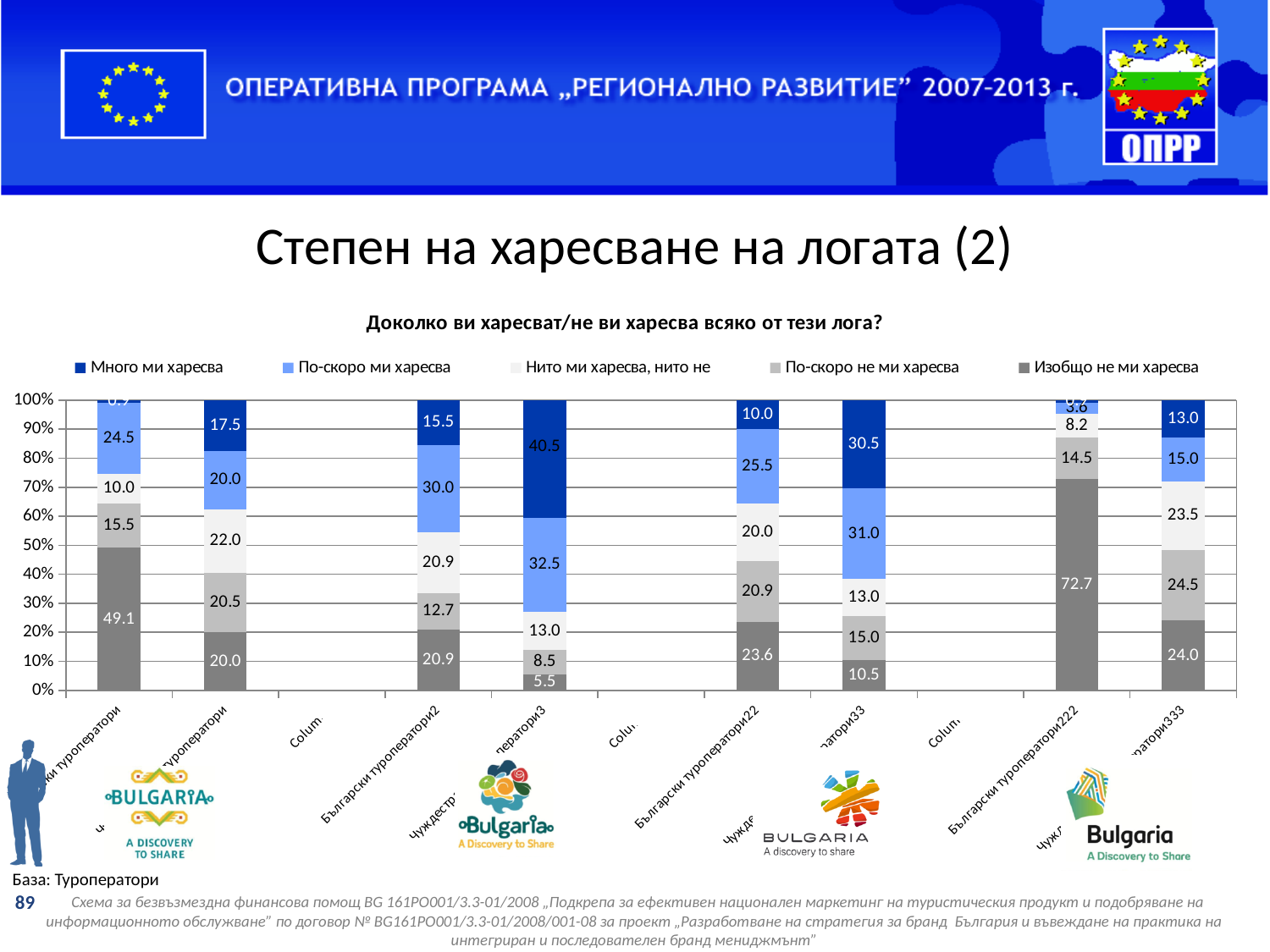
What is the value of "По-скоро ми харесва" for Български туроператори22? 25.5 What kind of chart is shown on the slide? Stacked bar chart What is the value of "По-скоро не ми харесва" for Български туроператори2? 12.7 What is the title of the chart? Доколко ви харесват/не ви харесва всяко от тези лога? How many series does the chart legend list? 5 Which category has the highest "Изобщо не ми харесва" value? Български туроператори222 For Български туроператори222, what is the difference between the "Изобщо не ми харесва" value and the "По-скоро не ми харесва" value? 58.2 Which is larger: the "Много ми харесва" value for Български туроператори2 or for Български туроператори22? Български туроператори2 What is the value of "Нито ми харесва, нито не" for Български туроператори22? 20.0 What is the value of "Изобщо не ми харесва" for Български туроператори222? 72.7 What is the largest "Много ми харесва" value shown on the chart? 40.5 What is the value of "Много ми харесва" for Български туроператори2? 15.5